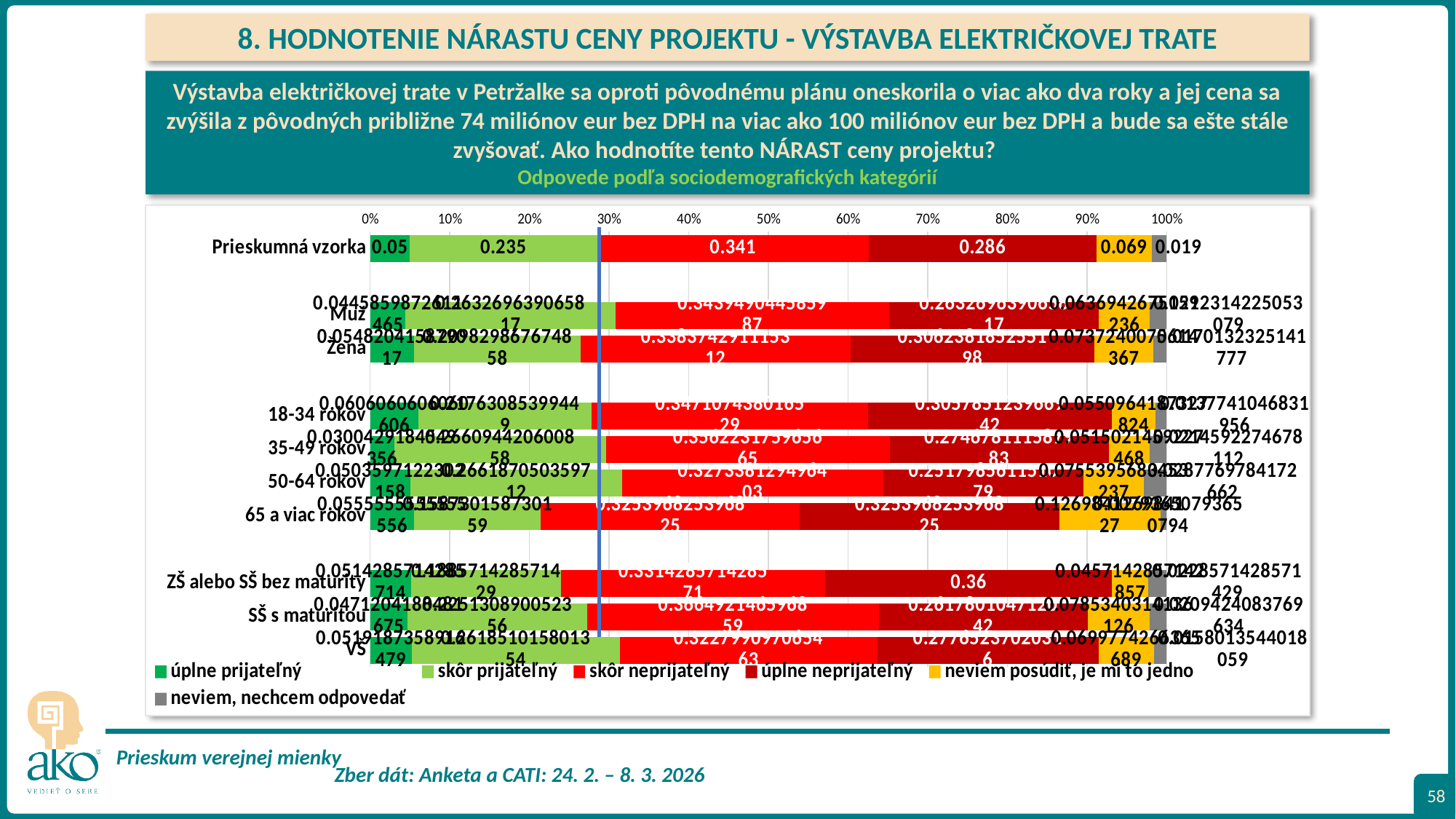
What is the value for 'skôr prijateľný' in the 'Prieskumná vzorka' row? 0.235 What is the value for 'skôr neprijateľný' in the 'Prieskumná vzorka' row? 0.341 Which response series has the largest value in the 'Prieskumná vzorka' row? skôr neprijateľný What is the value for 'úplne neprijateľný' in the 'ZŠ alebo SŠ bez maturity' row? 0.36 What kind of chart is shown on the slide? stacked bar chart In the 'Prieskumná vzorka' row, which is larger: 'skôr prijateľný' or 'úplne neprijateľný'? úplne neprijateľný What is the value for 'neviem, nechcem odpovedať' in the 'Prieskumná vzorka' row? 0.019 How many series does the legend list? 6 Which response series has the smallest value in the 'Prieskumná vzorka' row? neviem, nechcem odpovedať In the 'Prieskumná vzorka' row, what is the difference between 'skôr neprijateľný' and 'úplne neprijateľný'? 0.055 What is the value for 'úplne prijateľný' in the 'Prieskumná vzorka' row? 0.05 What is the value for 'úplne neprijateľný' in the 'Prieskumná vzorka' row? 0.286